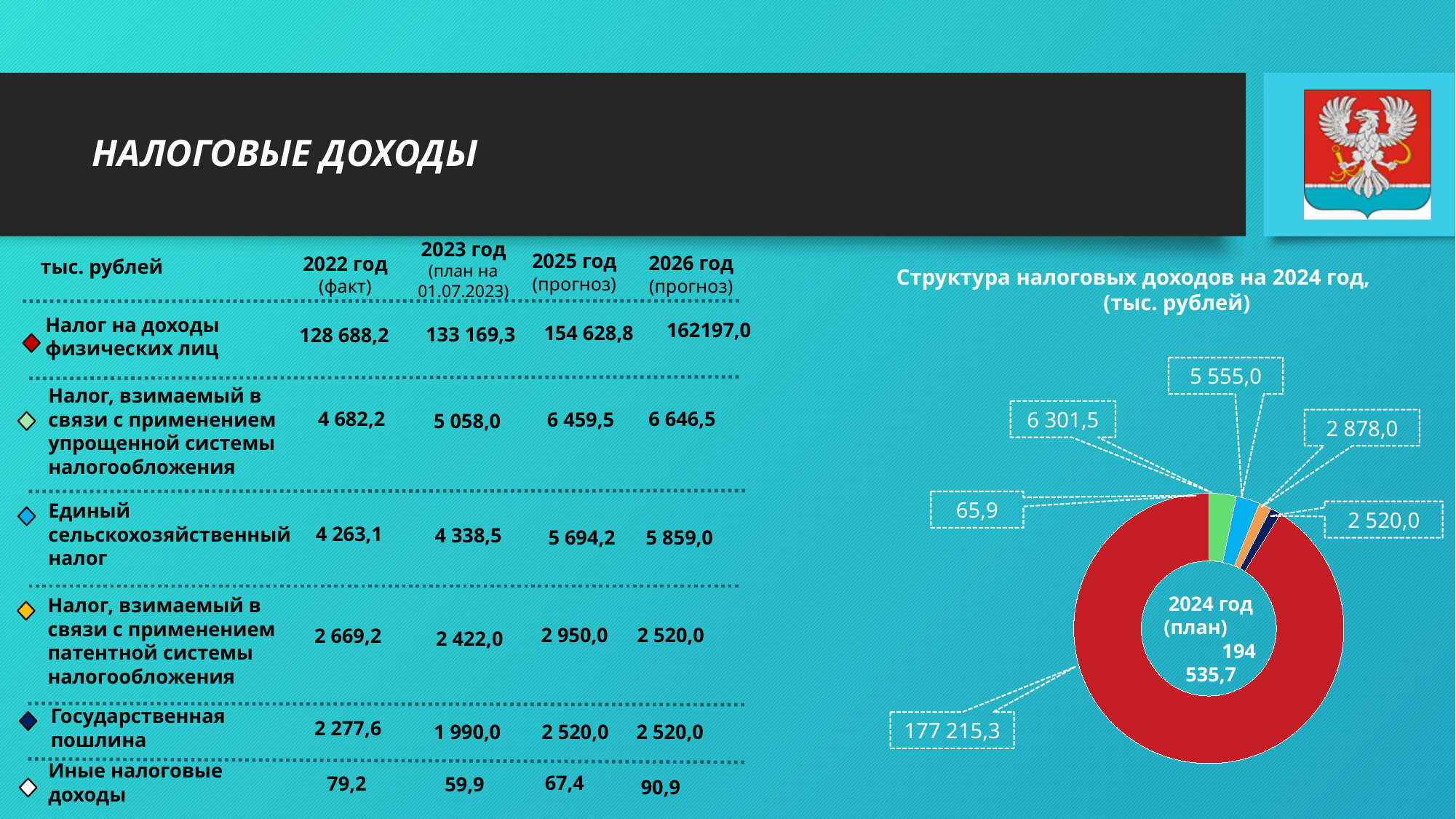
In the doughnut chart, what is the value of the smallest slice? 65,9 In the doughnut chart, how many slices have data labels? 6 What kind of chart is shown on the right side of the slide? doughnut chart In the doughnut chart, what share of the total 194 535,7 does the slice labelled 177 215,3 represent, to one decimal place? 91.1% What total value is printed in the centre of the doughnut chart? 194 535,7 In the doughnut chart, what is the difference between the slices labelled 6 301,5 and 5 555,0? 746,5 In the doughnut chart, what is the value of the largest slice? 177 215,3 What is the title of the chart on the right side of the slide? Структура налоговых доходов на 2024 год, (тыс. рублей) In the doughnut chart, what is the value of the green slice? 6 301,5 In the doughnut chart, what colour is the largest slice? red In the doughnut chart, what is the value of the light blue slice? 5 555,0 In the doughnut chart, which is larger: the orange slice (2 878,0) or the dark blue slice (2 520,0)? 2 878,0